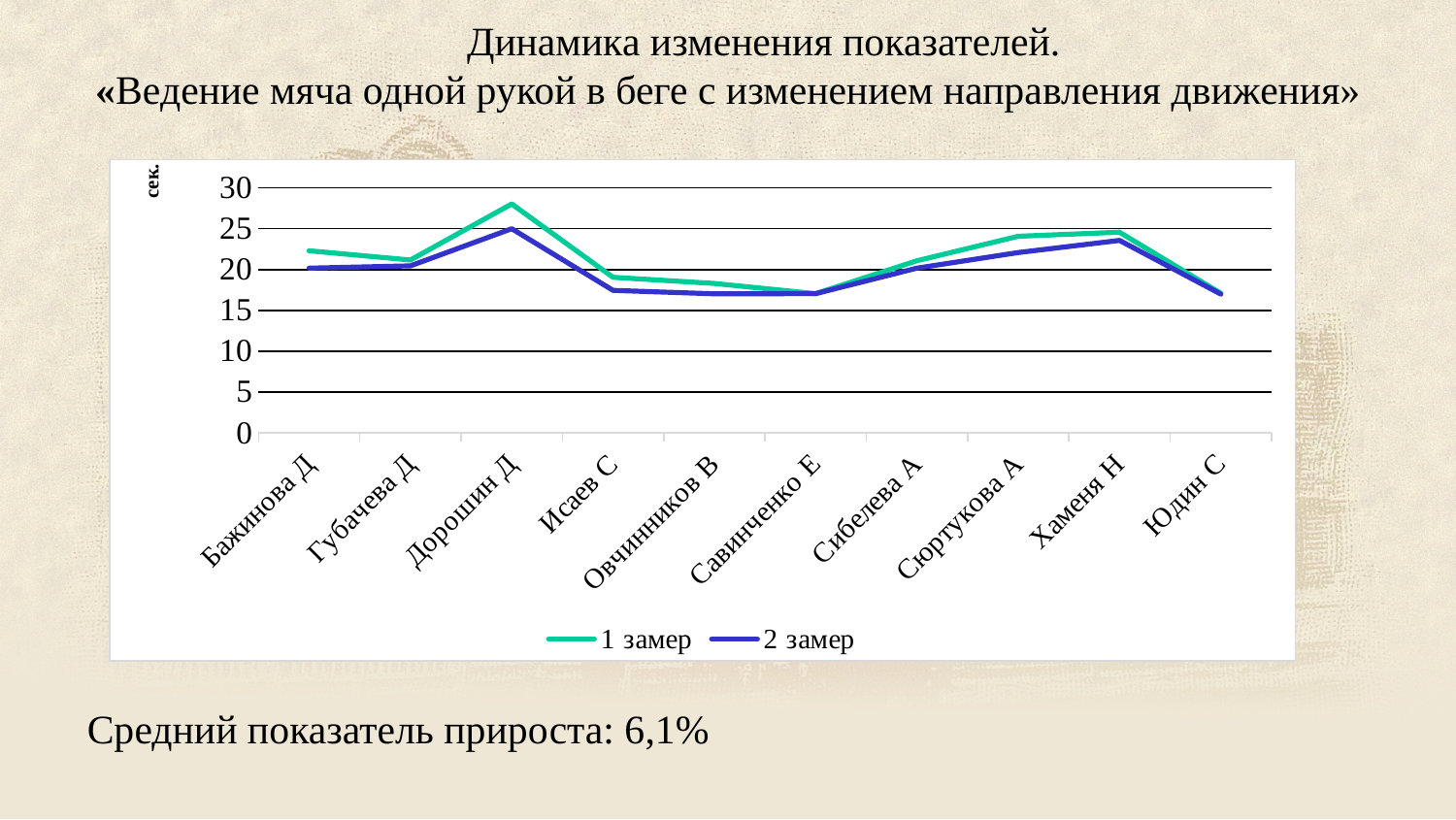
Which person has the highest value for the series "1 замер"? Дорошин Д What kind of chart is shown on the slide? line chart Which person has the highest value for the series "2 замер"? Дорошин Д Is the "1 замер" value for Сюртукова А greater or less than 20? greater Is the "2 замер" value for Исаев С greater or less than 20? less Is the "1 замер" value for Юдин С greater or less than 20? less How many people (categories) are plotted along the x axis? 10 What unit is written on the vertical axis of the chart? сек. For Бажинова Д, which series has the larger value: "1 замер" or "2 замер"? 1 замер For the series "1 замер", which is larger: the value for Дорошин Д or the value for Исаев С? Дорошин Д How many series does the legend list? 2